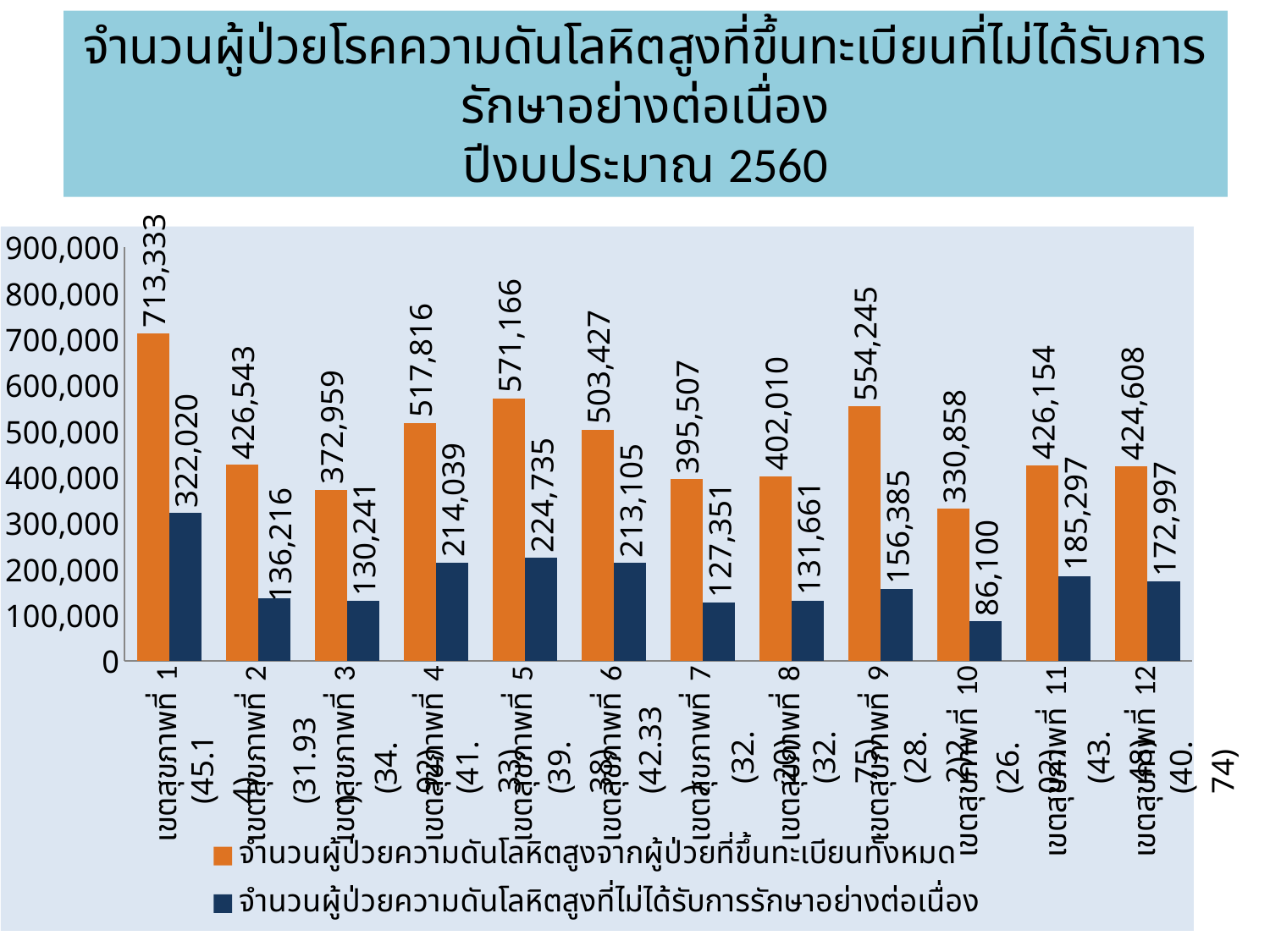
What is the value of จำนวนผู้ป่วยความดันโลหิตสูงจากผู้ป่วยที่ขึ้นทะเบียนทั้งหมด for เขตสุขภาพที่ 5? 571,166 What is the value of จำนวนผู้ป่วยความดันโลหิตสูงที่ไม่ได้รับการรักษาอย่างต่อเนื่อง for เขตสุขภาพที่ 10? 86,100 What is the value of จำนวนผู้ป่วยความดันโลหิตสูงจากผู้ป่วยที่ขึ้นทะเบียนทั้งหมด for เขตสุขภาพที่ 12? 424,608 Which region has the lowest value for จำนวนผู้ป่วยความดันโลหิตสูงจากผู้ป่วยที่ขึ้นทะเบียนทั้งหมด? เขตสุขภาพที่ 10 Which region has the highest value for จำนวนผู้ป่วยความดันโลหิตสูงจากผู้ป่วยที่ขึ้นทะเบียนทั้งหมด? เขตสุขภาพที่ 1 How many regions (categories) are shown on the x axis of the chart? 12 How many series does the legend list? 2 Which has the larger value for จำนวนผู้ป่วยความดันโลหิตสูงจากผู้ป่วยที่ขึ้นทะเบียนทั้งหมด, เขตสุขภาพที่ 4 or เขตสุขภาพที่ 9? เขตสุขภาพที่ 9 Is the value of จำนวนผู้ป่วยความดันโลหิตสูงที่ไม่ได้รับการรักษาอย่างต่อเนื่อง for เขตสุขภาพที่ 11 greater or less than 200,000? less For เขตสุขภาพที่ 1, what is the difference between จำนวนผู้ป่วยความดันโลหิตสูงจากผู้ป่วยที่ขึ้นทะเบียนทั้งหมด and จำนวนผู้ป่วยความดันโลหิตสูงที่ไม่ได้รับการรักษาอย่างต่อเนื่อง? 391,313 Which region has the lowest value for จำนวนผู้ป่วยความดันโลหิตสูงที่ไม่ได้รับการรักษาอย่างต่อเนื่อง? เขตสุขภาพที่ 10 What kind of chart is shown on the slide? bar chart